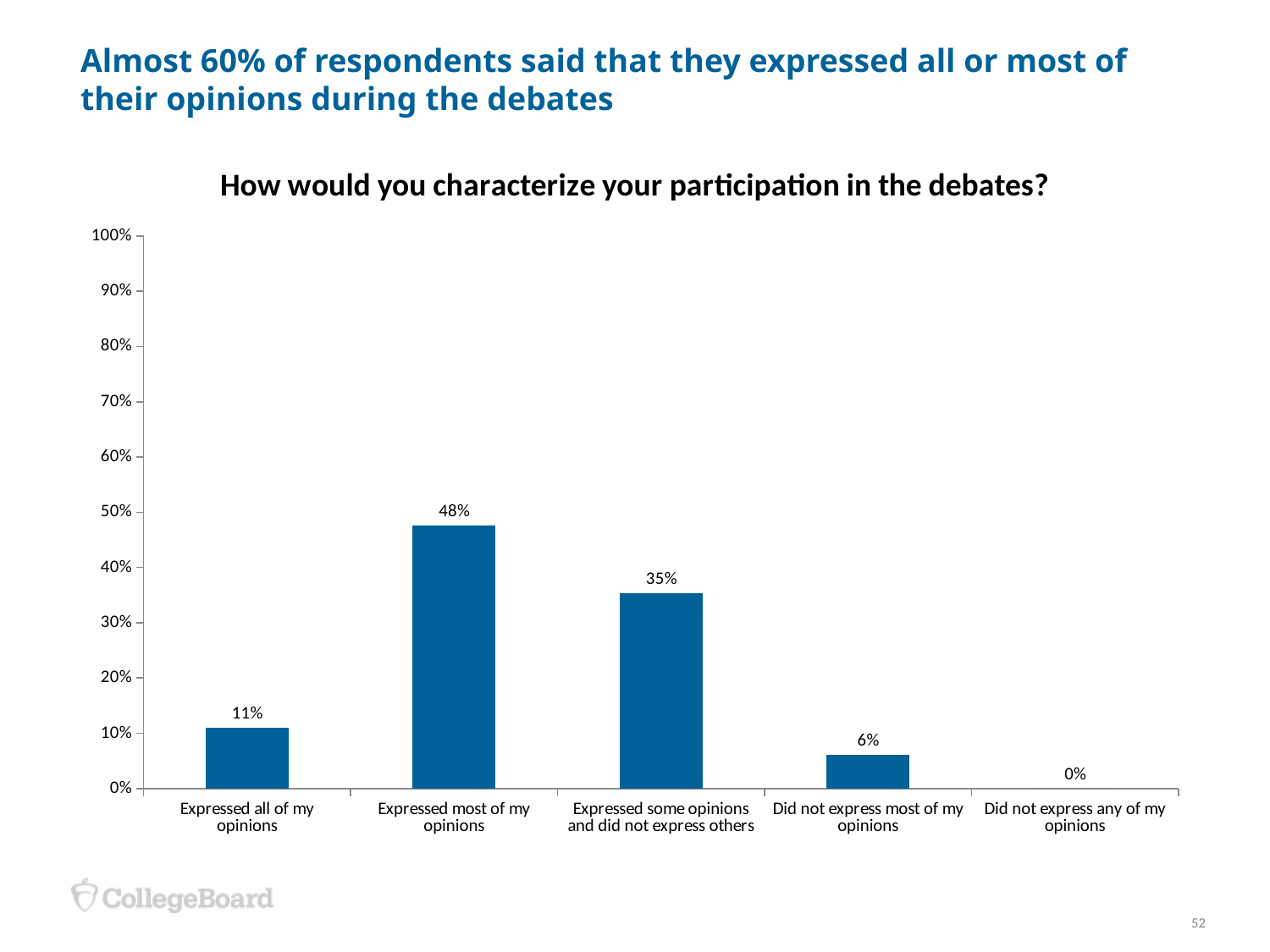
Which is larger: 'Expressed all of my opinions' or 'Did not express most of my opinions'? Expressed all of my opinions What is the value for 'Did not express any of my opinions'? 0% Which response category has the lowest value? Did not express any of my opinions What is the value for 'Did not express most of my opinions'? 6% What is the difference between 'Expressed most of my opinions' and 'Expressed some opinions and did not express others'? 13% What kind of chart is shown on the slide? Bar chart How many response categories are shown on the x axis? 5 What percentage of respondents said they expressed most of their opinions? 48% What is the title of the chart? How would you characterize your participation in the debates? Is the value for 'Expressed some opinions and did not express others' greater or less than 40%? less Which response category has the highest value? Expressed most of my opinions What percentage of respondents said they expressed all of their opinions? 11%